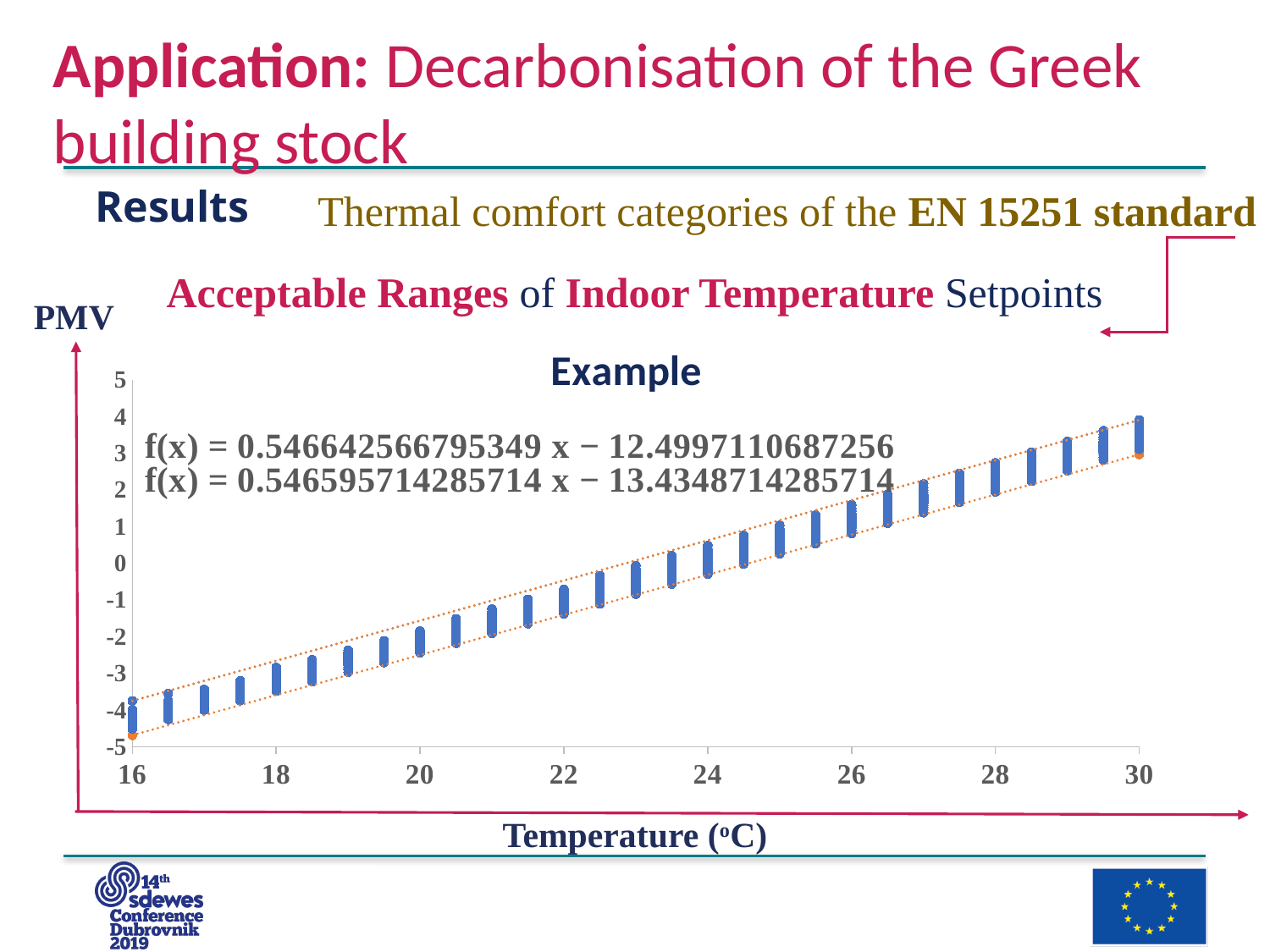
What is the intercept in the second trendline equation shown on the chart? −13.4348714285714 Are the PMV values at 16 °C greater or less than -3? less Are the PMV values at 22 °C greater or less than 0? less Do the PMV values rise or fall as temperature increases along the x axis? Rise What is the slope in the first trendline equation shown on the chart? 0.546642566795349 Are the PMV values at 30 °C greater or less than 2? greater How many trendline equations are printed on the chart? 2 What is the title of the chart? Example What are the lowest and highest temperature values labelled on the x axis? 16 and 30 What is the label of the horizontal axis of the chart? Temperature (°C) What kind of chart is shown on the slide? Scatter chart Which temperature has the larger PMV values, 16 °C or 30 °C? 30 °C